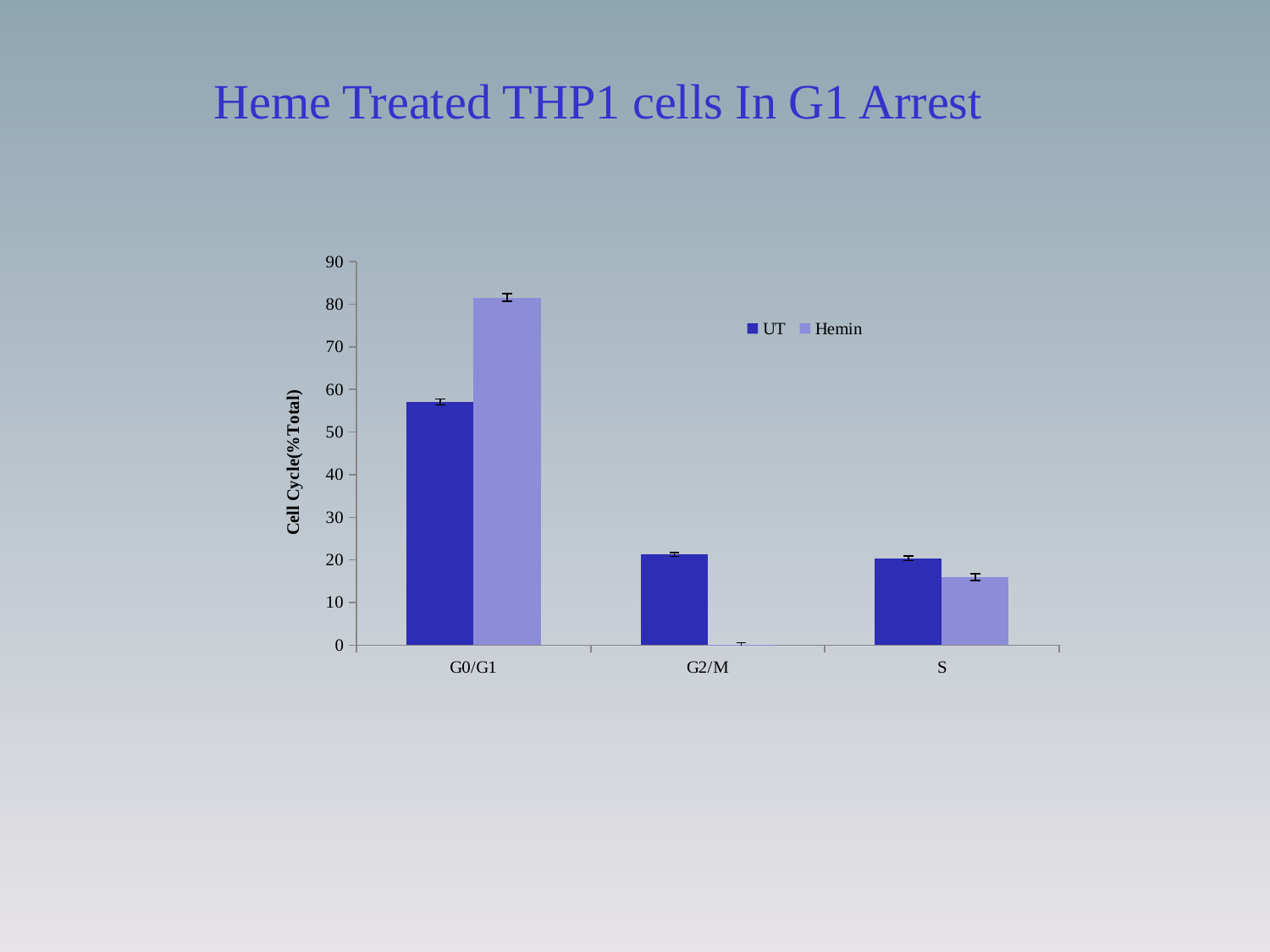
How many categories are shown on the x axis? 3 For S, which series has the larger value, UT or Hemin? UT Is the Hemin value for G0/G1 greater or less than 80? greater What kind of chart is shown on the slide? bar chart Which category has the lowest Hemin value? G2/M For G0/G1, which series has the larger value, UT or Hemin? Hemin What is the label of the y axis? Cell Cycle(%Total) Which category has the highest UT value? G0/G1 Is the UT value for G0/G1 greater or less than 60? less How many series does the legend list? 2 Which category has the highest Hemin value? G0/G1